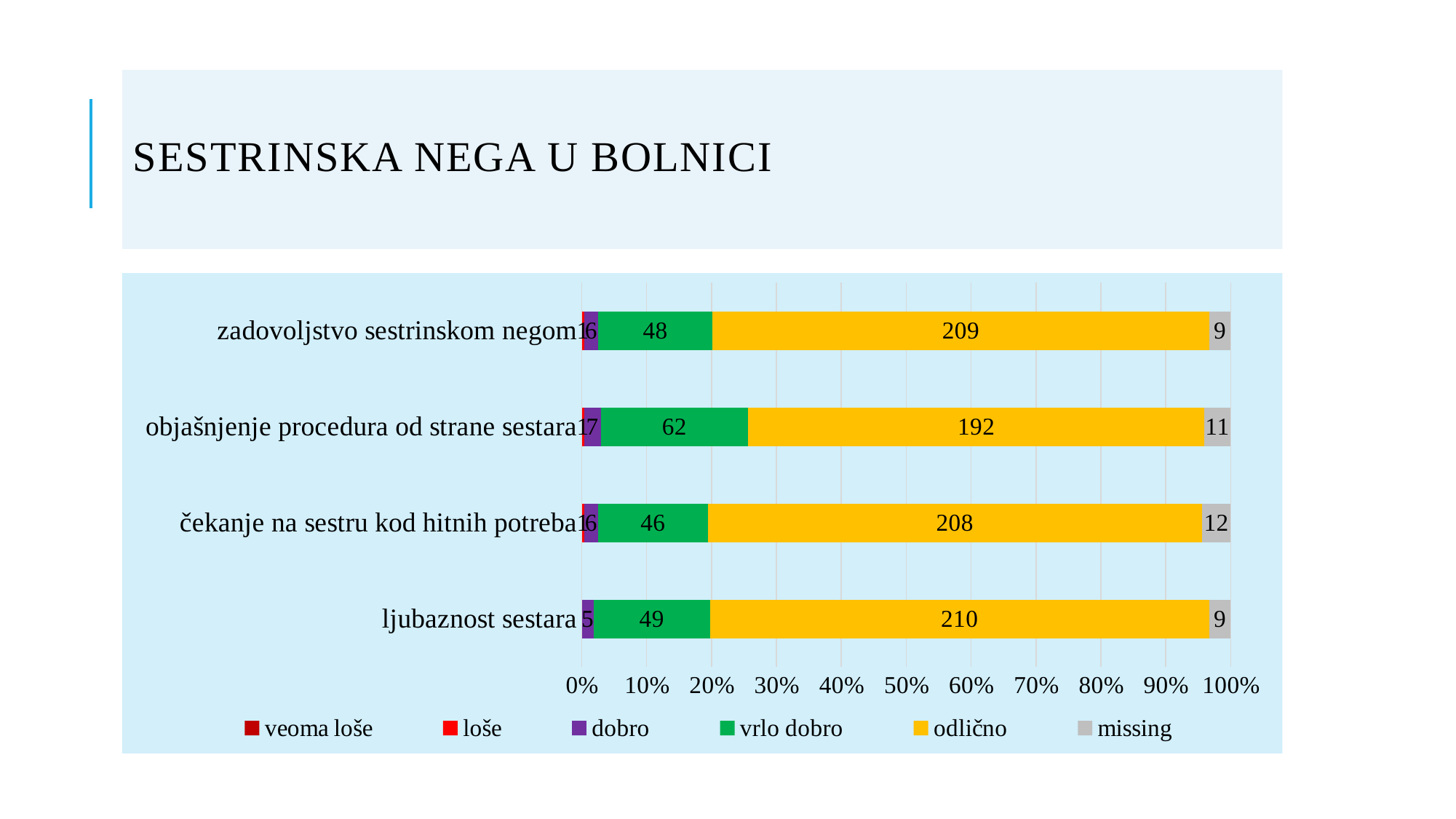
Which is larger: the 'vrlo dobro' value for 'zadovoljstvo sestrinskom negom' or for 'čekanje na sestru kod hitnih potreba'? zadovoljstvo sestrinskom negom Which category has the highest 'odlično' value? ljubaznost sestara How many categories are shown on the chart? 4 What colour represents the 'odlično' series in the chart? yellow What type of chart is shown on the slide? stacked bar chart What is the 'vrlo dobro' value for 'objašnjenje procedura od strane sestara'? 62 How many series does the legend list? 6 What is the difference between the 'odlično' values for 'zadovoljstvo sestrinskom negom' and 'objašnjenje procedura od strane sestara'? 17 Which category has the lowest 'odlično' value? objašnjenje procedura od strane sestara What is the 'odlično' value for 'ljubaznost sestara'? 210 What is the title of the slide containing the chart? SESTRINSKA NEGA U BOLNICI What is the 'missing' value for 'čekanje na sestru kod hitnih potreba'? 12